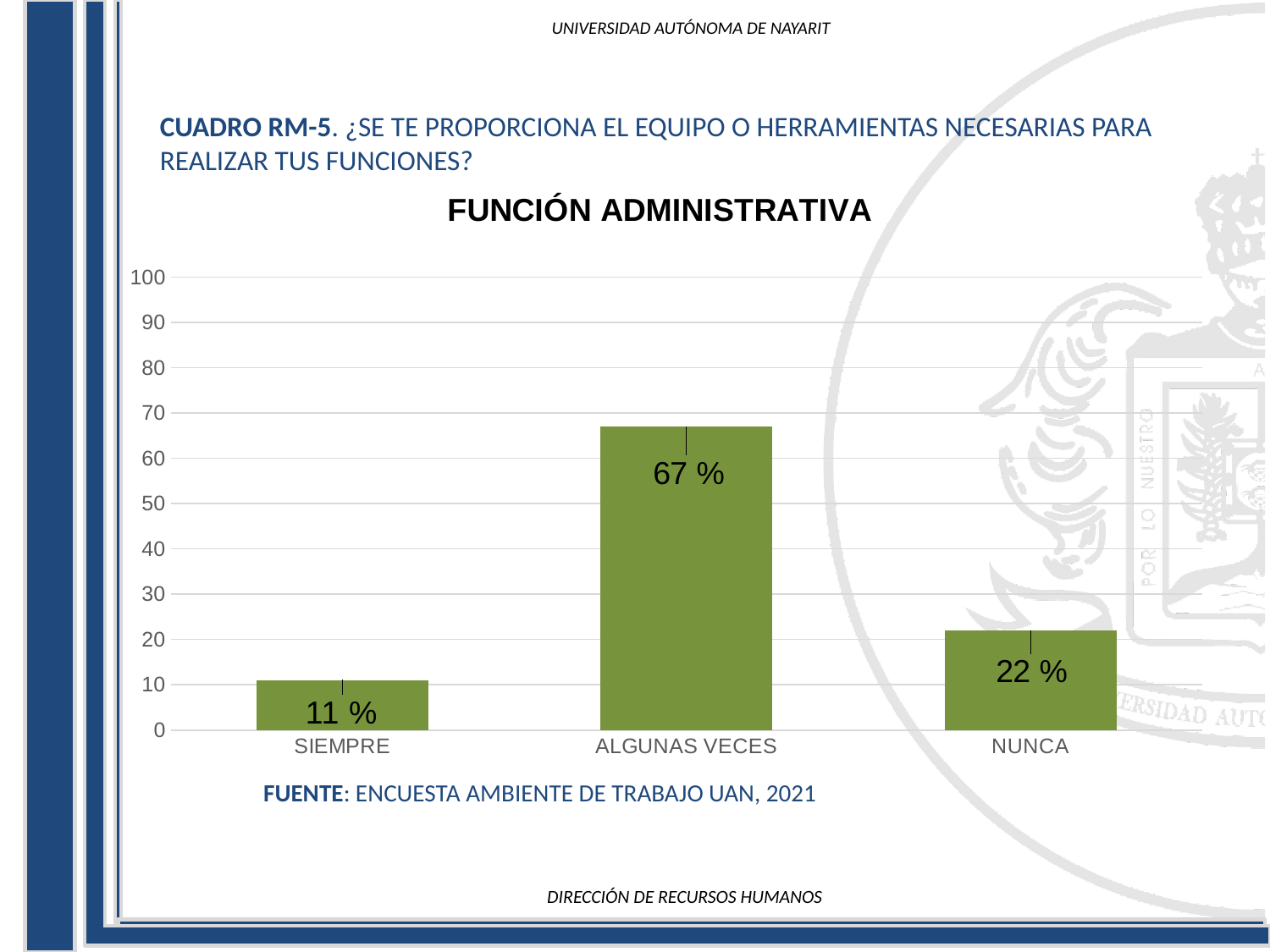
How many categories are shown on the x axis? 3 What is the difference between the values for ALGUNAS VECES and NUNCA? 45 % What is the value for ALGUNAS VECES? 67 % What is the value for NUNCA? 22 % Which category has the lowest value? SIEMPRE Which category has the highest value? ALGUNAS VECES What kind of chart is shown on the slide? bar chart Is the value for ALGUNAS VECES greater or less than 50? greater Which is larger, the value for NUNCA or the value for SIEMPRE? NUNCA What is the value for SIEMPRE? 11 % What is the title of the chart? FUNCIÓN ADMINISTRATIVA What is the difference between the values for NUNCA and SIEMPRE? 11 %